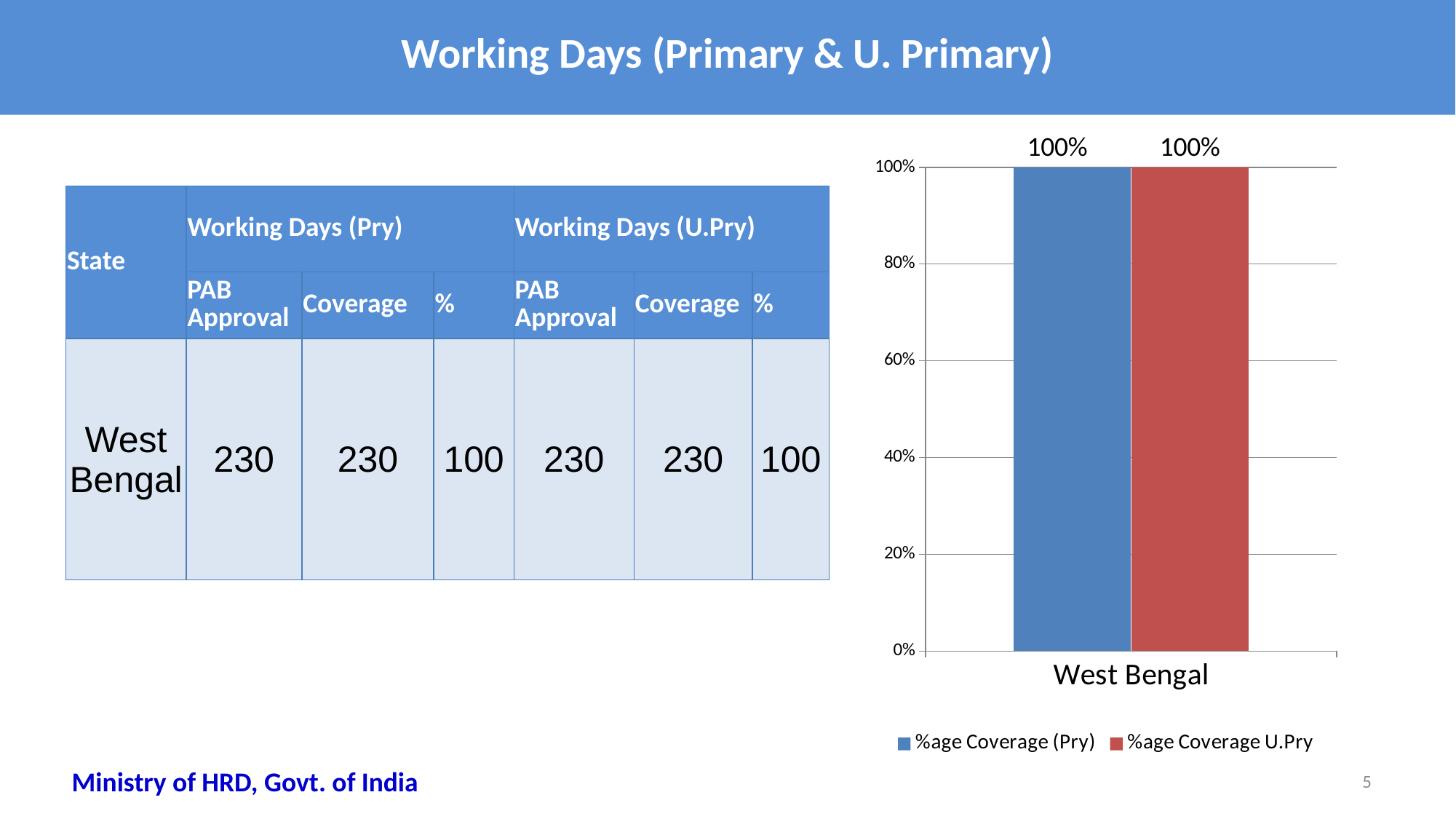
What is the highest tick value shown on the y axis of the chart? 100% What is the value of %age Coverage U.Pry for West Bengal in the chart? 100% Which category is shown on the x axis of the chart? West Bengal What is the value of %age Coverage (Pry) for West Bengal in the chart? 100% Is the value for %age Coverage (Pry) for West Bengal greater or less than 80%? greater Is the value for %age Coverage U.Pry for West Bengal greater or less than 60%? greater What colour is the bar for %age Coverage U.Pry in the chart? red How many categories are shown on the x axis of the chart? 1 What is the difference between %age Coverage (Pry) and %age Coverage U.Pry for West Bengal? 0% How many series does the chart's legend list? 2 What kind of chart is shown on the slide? bar chart